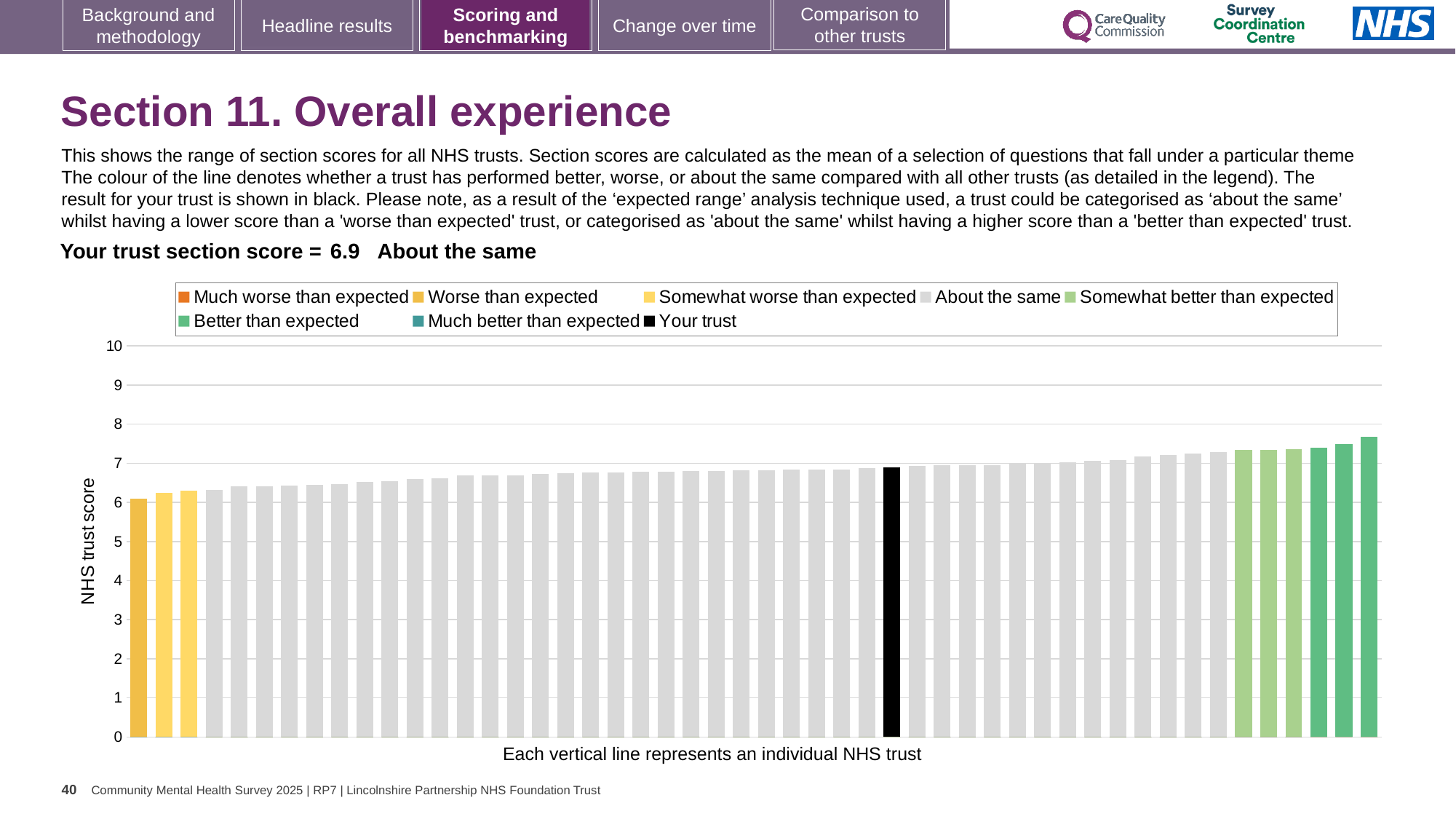
Which bar has the highest value: the leftmost bar or the rightmost bar? the rightmost bar What kind of chart is shown on the slide? Bar chart What is the maximum value shown on the vertical axis? 10 Which category is your trust placed in according to the slide? About the same What colour is the bar representing your trust? Black Is the value for your trust (the black bar) greater or less than 6? greater Do the bar values rise or fall from left to right along the x axis? rise Is the value of the leftmost bar greater or less than 5? greater Is the value of the tallest bar greater or less than 8? less How many entries does the chart legend list? 8 What is the section score for your trust shown on the slide? 6.9 What is the label on the vertical axis of the chart? NHS trust score